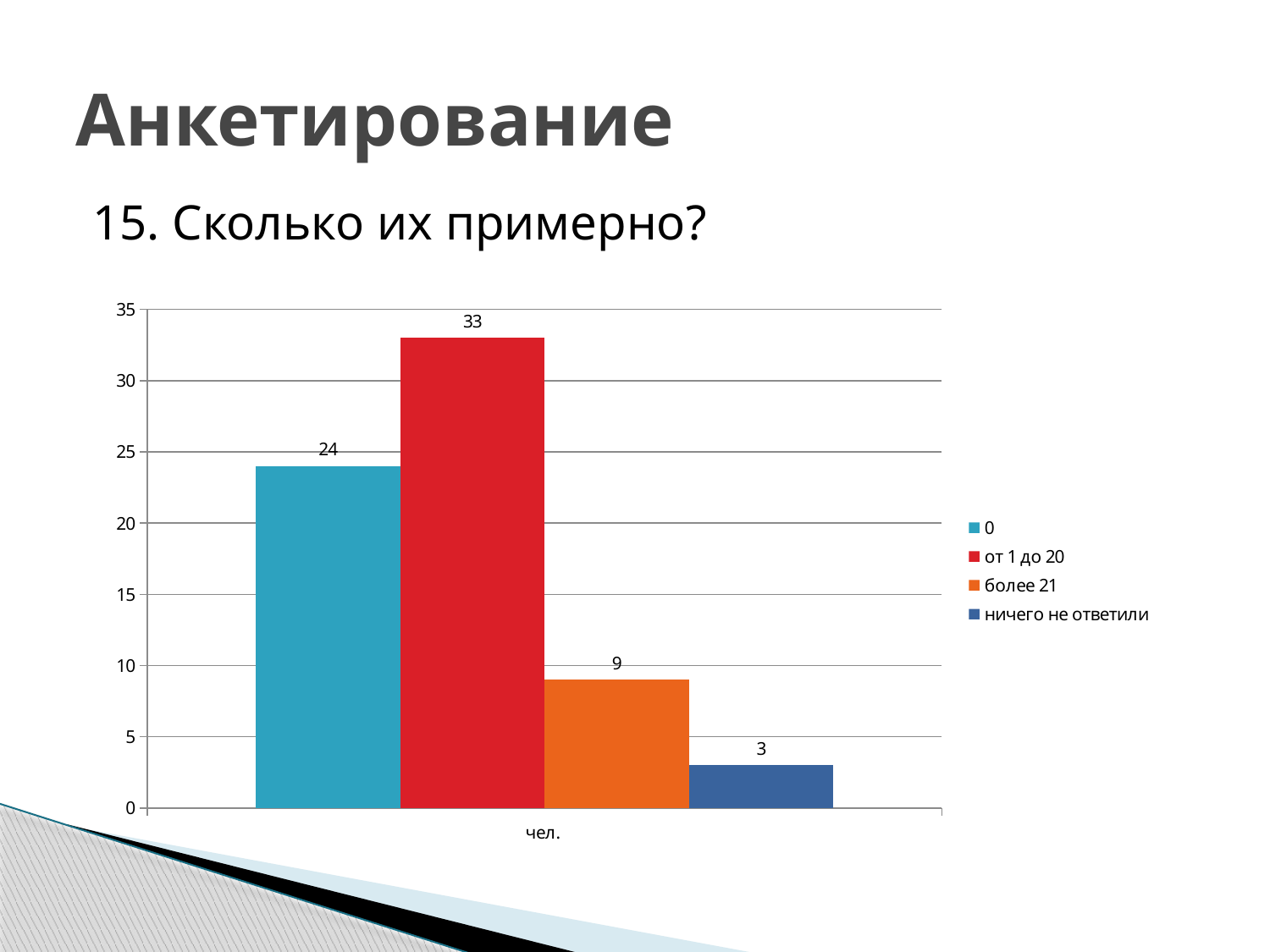
What is the value for the series "от 1 до 20"? 33 What is the value for the series "более 21"? 9 How many series does the legend list? 4 What is the value for the series "ничего не ответили"? 3 Which is larger, the value for "более 21" or the value for "ничего не ответили"? более 21 Which series has the highest value? от 1 до 20 What kind of chart is shown on the slide? bar chart What is the label shown on the x axis of the chart? чел. What is the value for the series "0"? 24 Which series has the lowest value? ничего не ответили What is the difference between the values for "от 1 до 20" and "0"? 9 Is the value for "0" greater or less than 20? greater